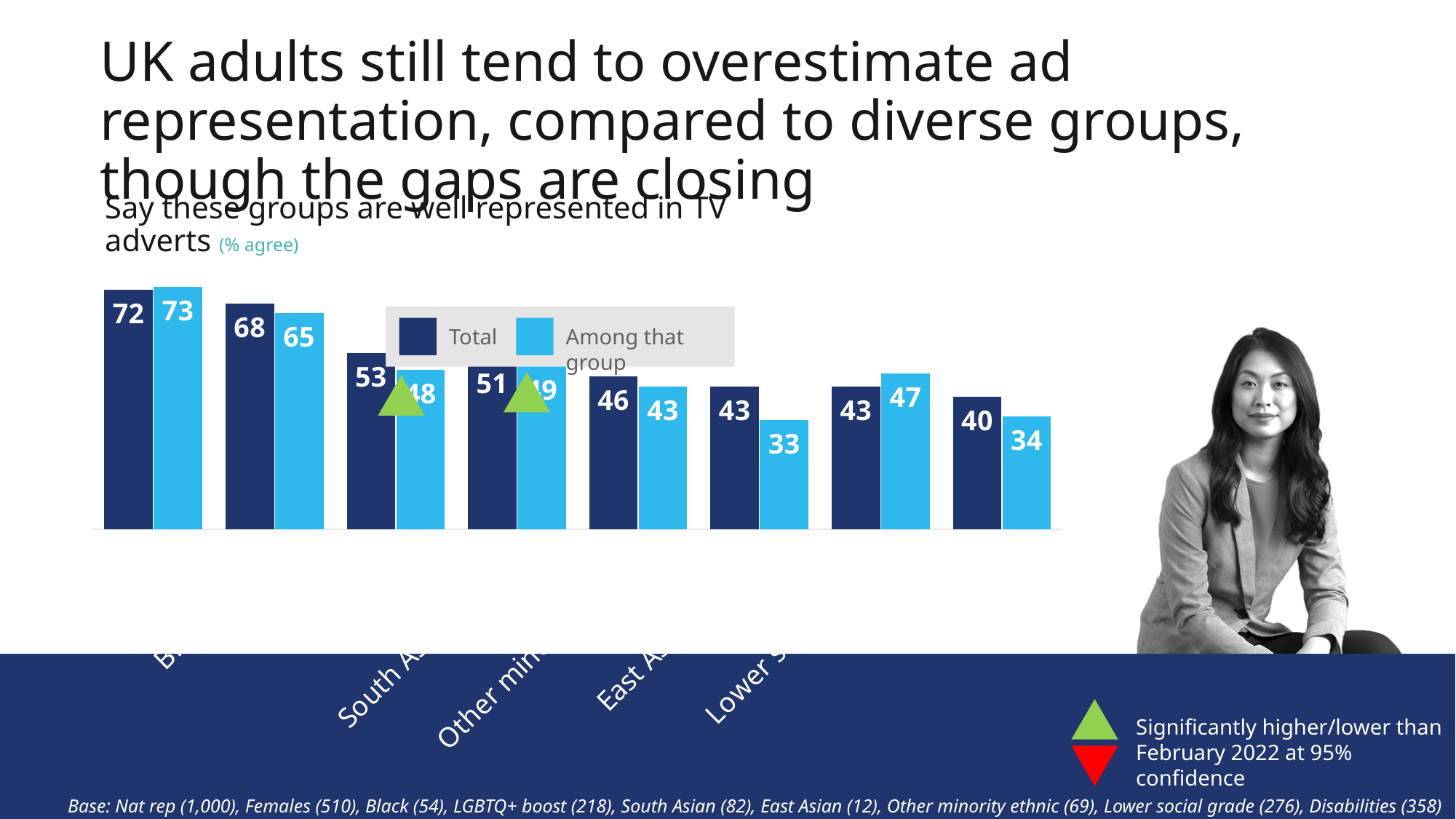
What are the two series named in the chart legend? Total and Among that group What is the highest Total value shown in the chart? 72 What is the lowest Among that group value shown in the chart? 33 For the rightmost group, what is the difference between the Total value (40) and the Among that group value (34)? 6 How many series does the chart legend list? 2 What kind of chart is shown on the slide? bar chart For the sixth group from the left, what is the difference between the Total value (43) and the Among that group value (33)? 10 What is the Among that group value for the second group from the left? 65 How many groups (pairs of bars) are plotted in the chart? 8 For the seventh group from the left, which is larger: the Total value or the Among that group value? Among that group What is the Among that group value for the leftmost group in the chart? 73 What is the Total value for the leftmost group in the chart? 72